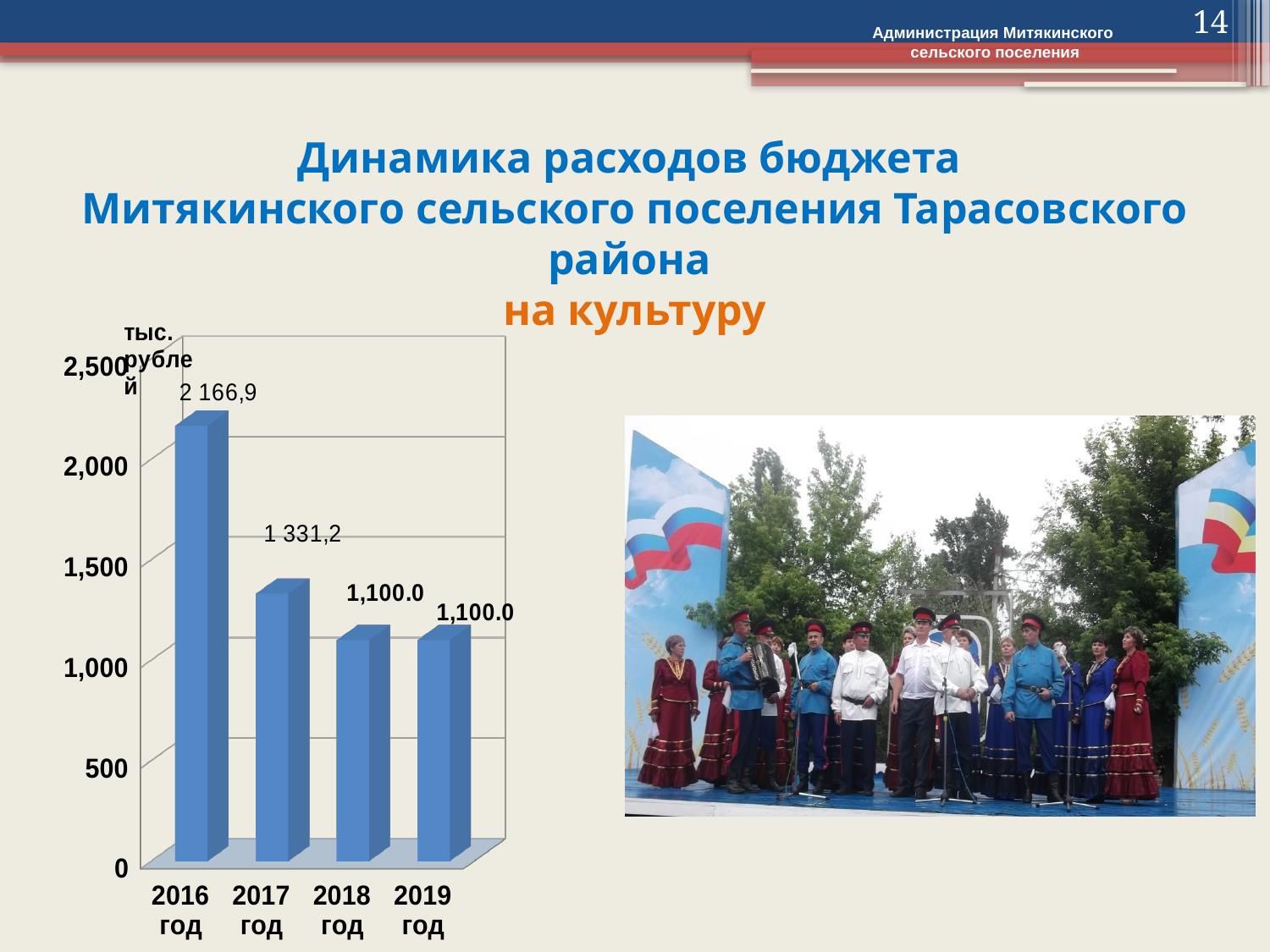
How many years are shown on the chart? 4 What is the difference between the values for 2016 год and 2017 год? 835,7 What kind of chart is shown on the slide? bar chart What unit is shown on the vertical axis of the chart? тыс. рублей What is the value for 2016 год? 2 166,9 Which year has the highest value? 2016 год What is the value for 2017 год? 1 331,2 What is the value for 2019 год? 1,100.0 Which is larger, the value for 2017 год or the value for 2018 год? 2017 год Do the values rise or fall from 2016 год to 2018 год? fall What is the value for 2018 год? 1,100.0 Is the value for 2016 год greater or less than 2,000? greater